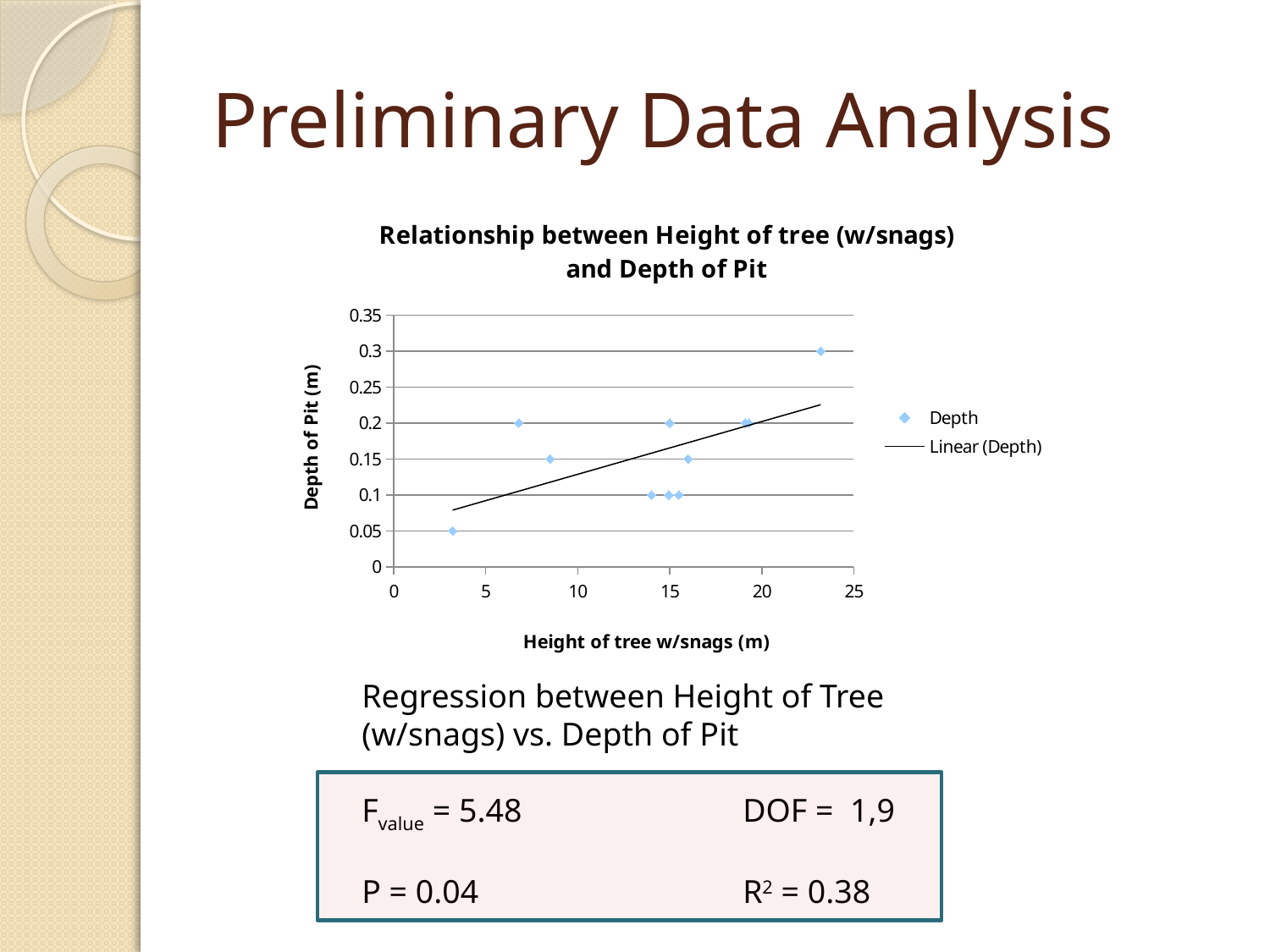
What is the highest Depth of Pit value plotted on the chart? 0.3 What is the maximum value shown on the x axis? 25 What is the difference between the highest and lowest Depth of Pit values plotted? 0.25 Which has a greater Depth of Pit: the point at about 23 m height or the point at about 3 m height? The point at about 23 m What is the label of the y axis? Depth of Pit (m) Does the linear trendline rise or fall as Height of tree increases? Rises What is the title of the chart? Relationship between Height of tree (w/snags) and Depth of Pit What is the lowest Depth of Pit value plotted on the chart? 0.05 Is the Depth of Pit for the shortest tree (around 3 m) greater or less than 0.1? less What kind of chart is shown on the slide? Scatter chart How many entries does the chart legend list? 2 Is the Depth of Pit for the tallest tree (around 23 m) greater or less than 0.25? greater